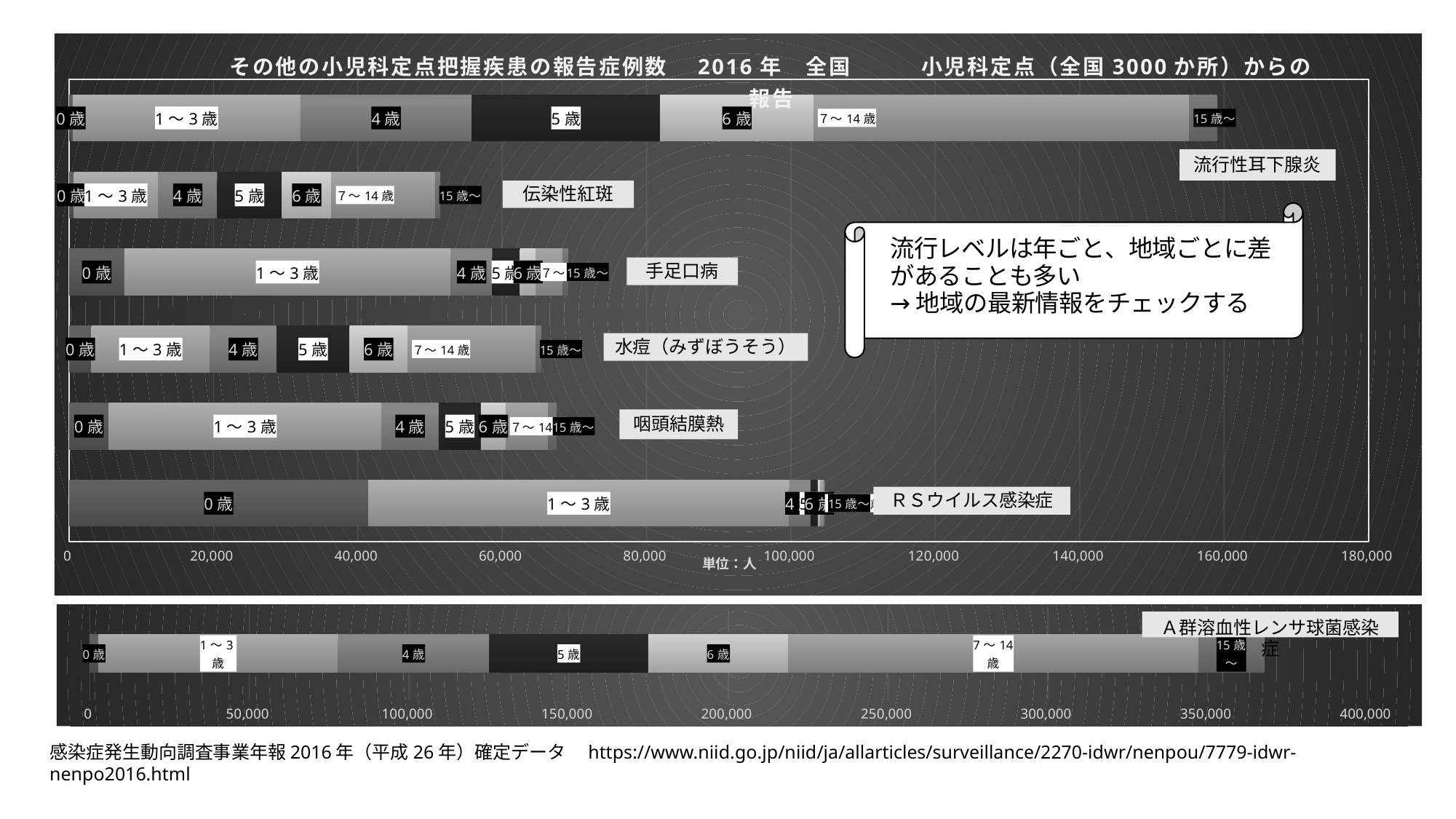
How many age-group segments make up the bar in the bottom chart? 7 In the bottom chart, is the total for A群溶血性レンサ球菌感染症 greater or less than 350,000? greater In the top chart, which age group is the largest segment of the RSウイルス感染症 bar? 1〜3歳 In the top chart, is the total for RSウイルス感染症 greater or less than 100,000? greater In the top chart, which has a larger total: RSウイルス感染症 or 水痘（みずぼうそう）? RSウイルス感染症 How many diseases are plotted in the top chart? 6 In the top chart, is the total for 手足口病 greater or less than 80,000? less In the top chart, which disease has the lowest total number of reported cases? 伝染性紅斑 What kind of chart is the top chart on the slide? bar chart What unit is shown below the x axis of the top chart? 単位：人 In the top chart, which disease has the highest total number of reported cases? 流行性耳下腺炎